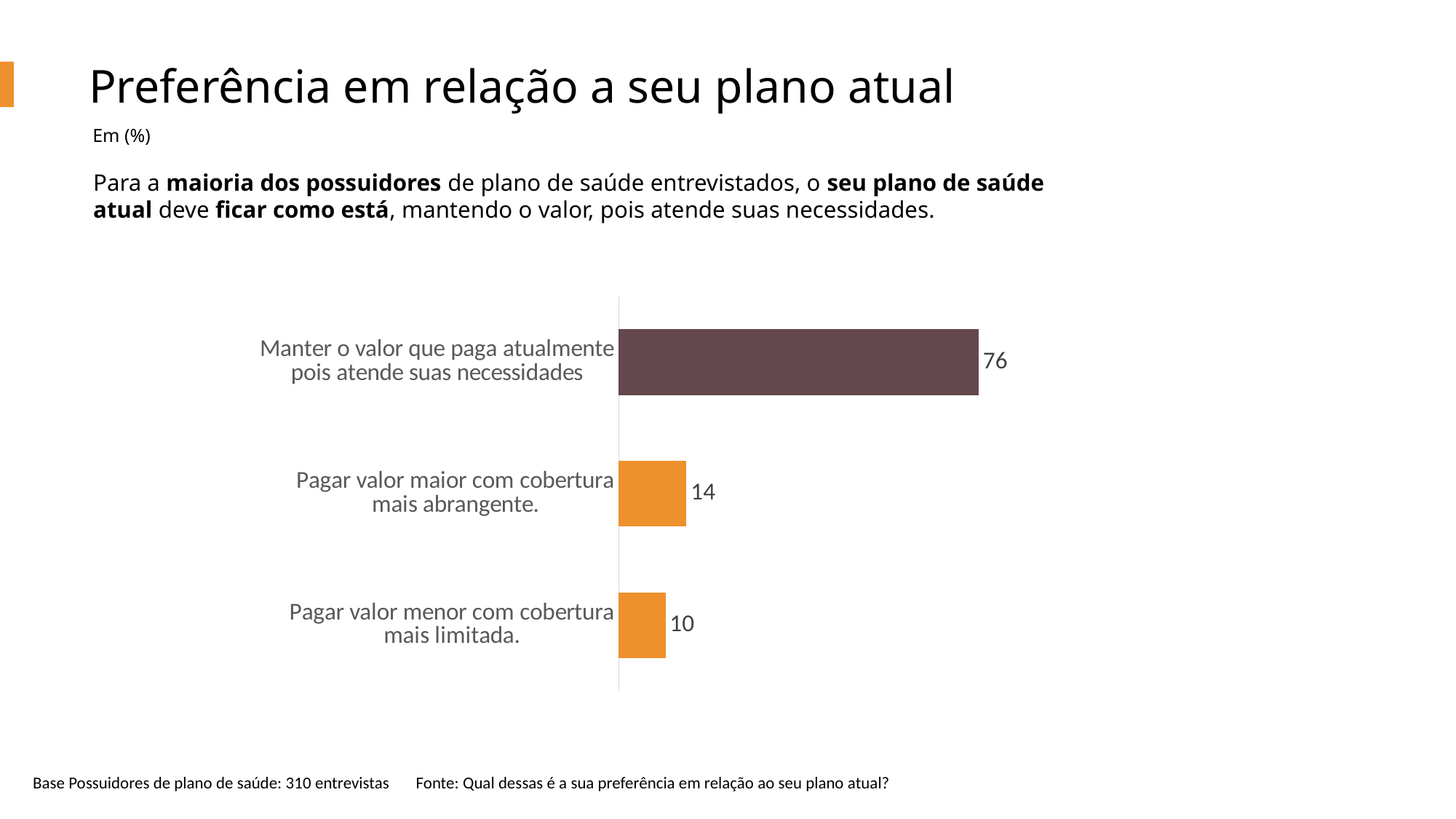
What is the value for "Manter o valor que paga atualmente pois atende suas necessidades"? 76 Which category has the highest value? Manter o valor que paga atualmente pois atende suas necessidades What is the value for "Pagar valor menor com cobertura mais limitada."? 10 What is the difference between the values for "Pagar valor maior com cobertura mais abrangente." and "Pagar valor menor com cobertura mais limitada."? 4 How many categories are shown in the chart? 3 What is the value for "Pagar valor maior com cobertura mais abrangente."? 14 What kind of chart is shown on the slide? Bar chart What colour is the bar for "Manter o valor que paga atualmente pois atende suas necessidades"? Dark brown/purple Which is larger: the value for "Pagar valor maior com cobertura mais abrangente." or for "Pagar valor menor com cobertura mais limitada."? Pagar valor maior com cobertura mais abrangente. What is the difference between the values for "Manter o valor que paga atualmente pois atende suas necessidades" and "Pagar valor maior com cobertura mais abrangente."? 62 What is the title of the slide containing the chart? Preferência em relação a seu plano atual Which category has the lowest value? Pagar valor menor com cobertura mais limitada.